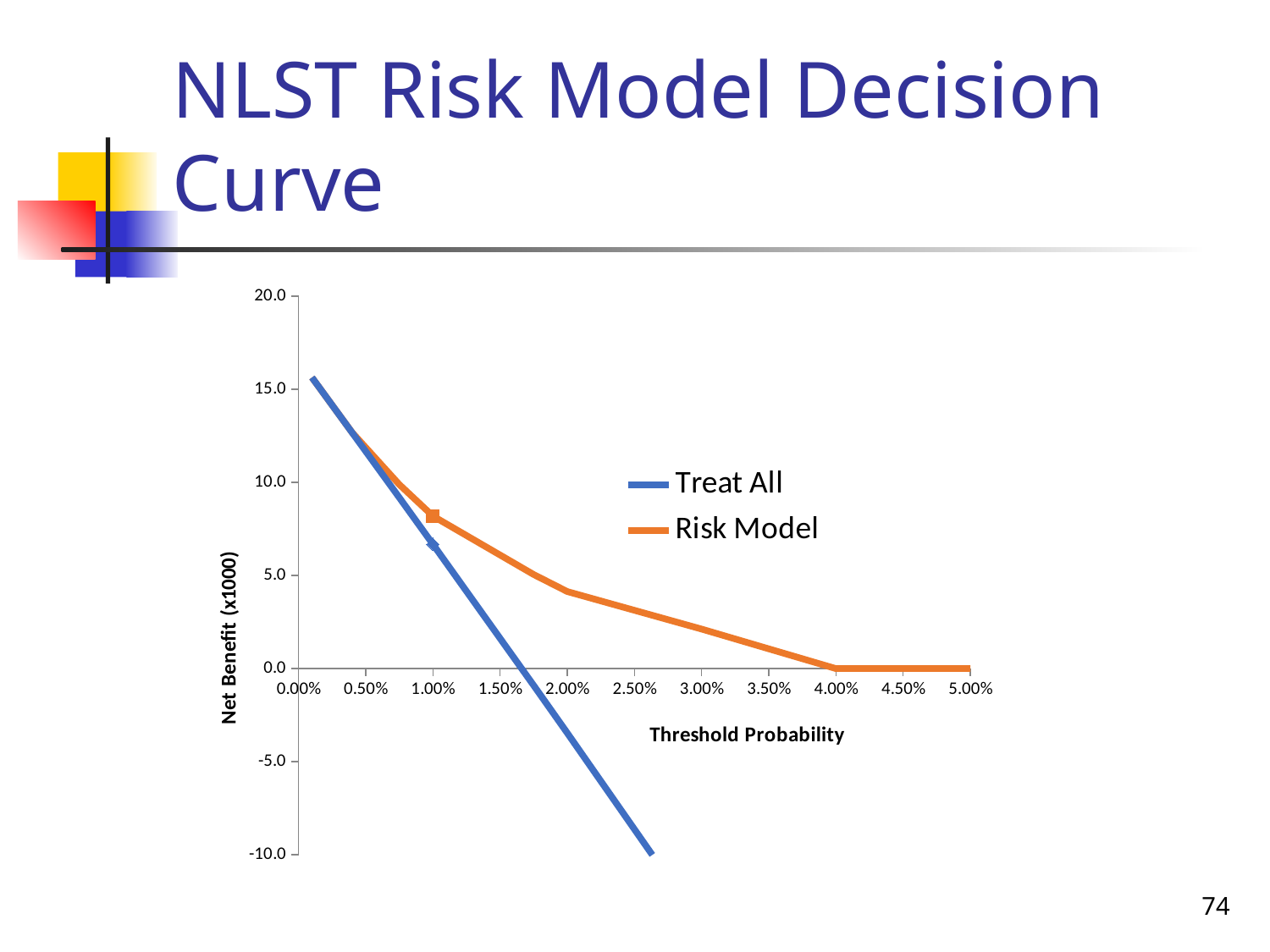
Is the Risk Model value at 1.00% greater or less than 5.0? greater Is the Treat All value at 0.50% greater or less than 10.0? greater What are the two series named in the legend? Treat All and Risk Model What is the title of the vertical axis? Net Benefit (x1000) Does the Risk Model line rise or fall as Threshold Probability increases? fall Is the Treat All value at 2.00% greater or less than 0.0? less At a Threshold Probability of 2.00%, which series has the higher Net Benefit, Treat All or Risk Model? Risk Model What kind of chart is shown on the slide? line chart How many series does the legend list? 2 Does the Treat All line rise or fall as Threshold Probability increases? fall